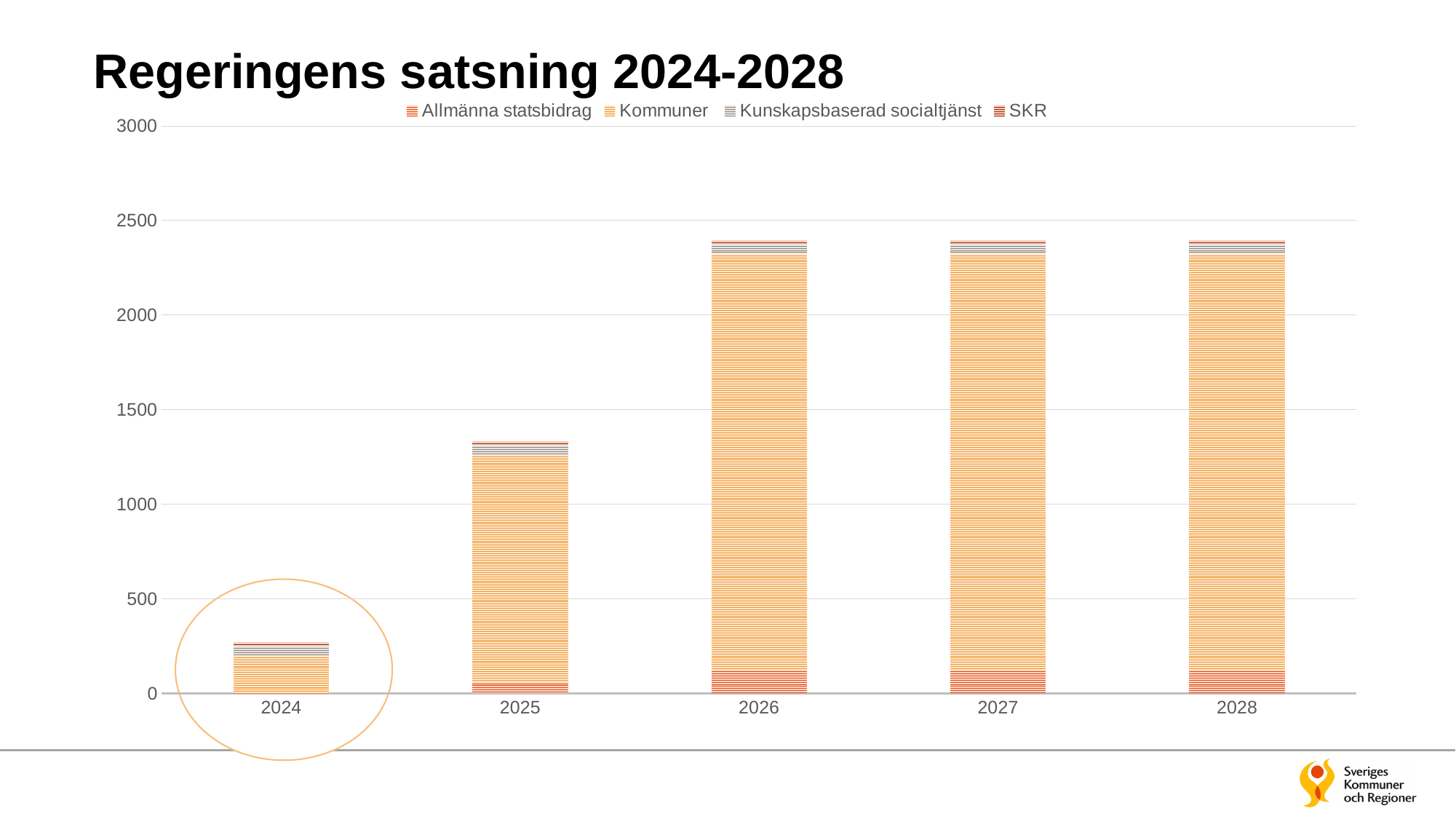
Is the total bar for 2025 greater or less than 1500? less Is the total bar for 2024 greater or less than 500? less Is the total bar for 2026 greater or less than 2500? less Do the total bars rise or fall from 2024 to 2026? rise What is the title of the chart on the slide? Regeringens satsning 2024-2028 Which year has the lowest total bar in the chart? 2024 How many series does the chart legend list? 4 Which year has the larger total bar, 2025 or 2026? 2026 How many years are shown on the x axis of the chart? 5 What kind of chart is shown on the slide? bar chart